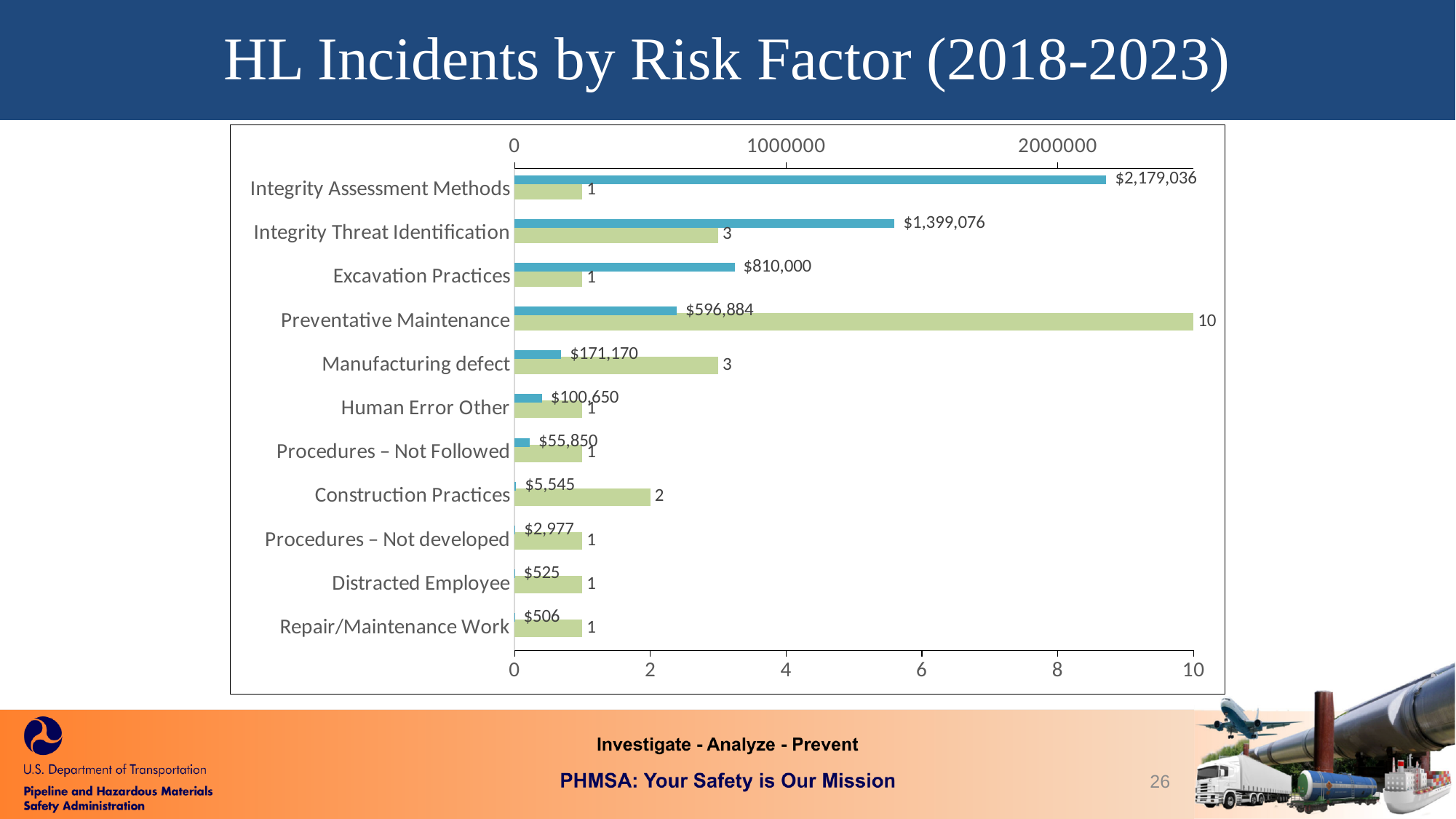
What is the dollar value shown for Preventative Maintenance? $596,884 What is the dollar value shown for Integrity Assessment Methods? $2,179,036 How many risk factor categories are shown on the chart? 11 What is the count (green bar) shown for Preventative Maintenance? 10 Which risk factor has the highest count (green bar)? Preventative Maintenance What is the title of the slide containing the chart? HL Incidents by Risk Factor (2018-2023) Which risk factor has the highest dollar value (blue bar)? Integrity Assessment Methods What is the count (green bar) shown for Construction Practices? 2 What kind of chart is shown on the slide? Bar chart Which has a larger dollar value, Excavation Practices or Manufacturing defect? Excavation Practices Which risk factor has the lowest dollar value (blue bar)? Repair/Maintenance Work What is the difference in dollar value between Integrity Assessment Methods and Integrity Threat Identification? $779,960